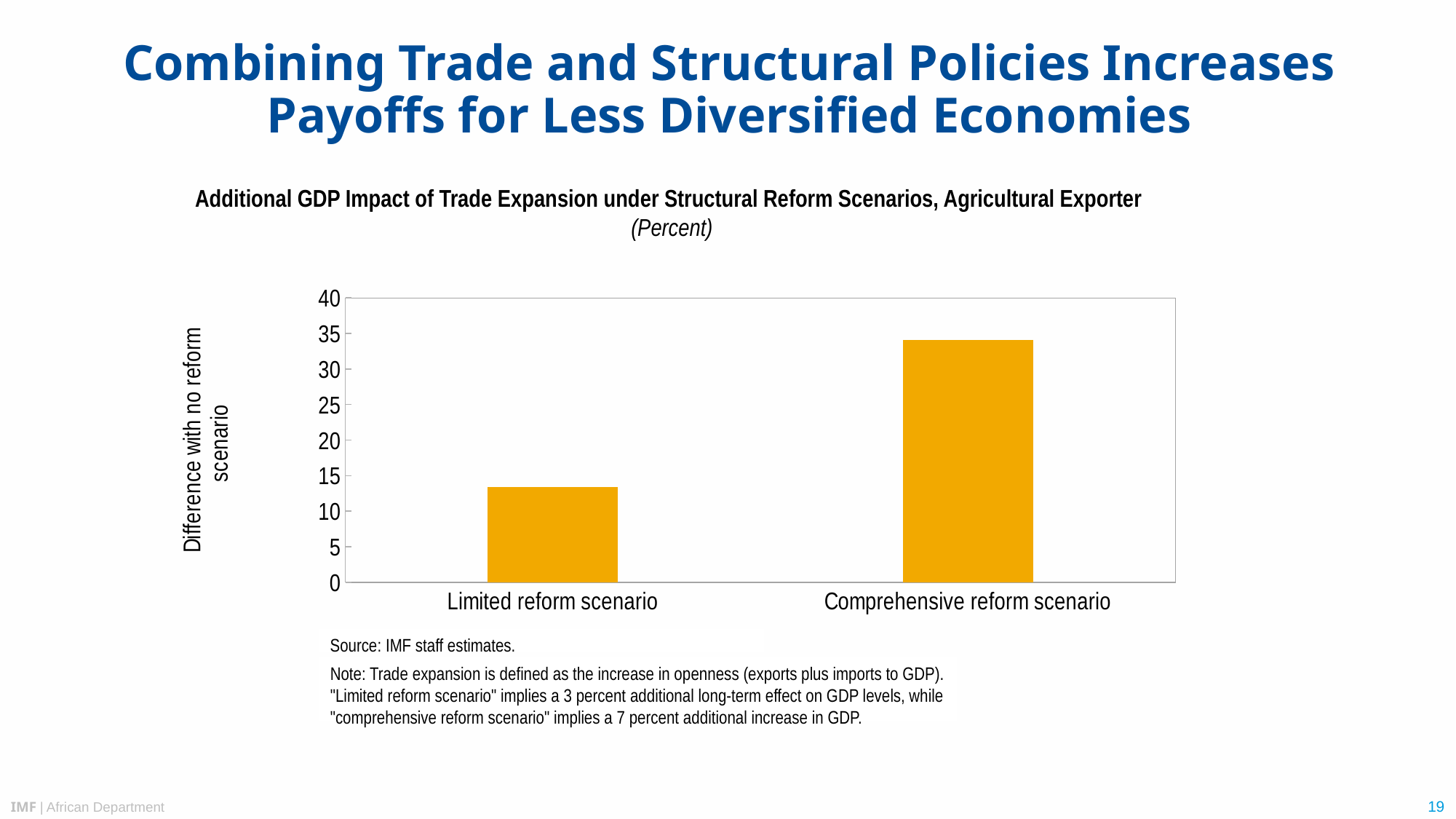
Which scenario has the higher additional GDP impact? Comprehensive reform scenario Which is larger: the value for the Limited reform scenario or the Comprehensive reform scenario? Comprehensive reform scenario Is the value for the Limited reform scenario greater or less than 15? less Is the value for the Comprehensive reform scenario greater or less than 30? greater Is the value for the Limited reform scenario greater or less than 10? greater What is the label on the vertical axis of the chart? Difference with no reform scenario What is the maximum value shown on the vertical axis? 40 How many bars (categories) does the chart show? 2 What kind of chart is shown on the slide? bar chart Which scenario has the lower additional GDP impact? Limited reform scenario What is the title of the chart? Additional GDP Impact of Trade Expansion under Structural Reform Scenarios, Agricultural Exporter